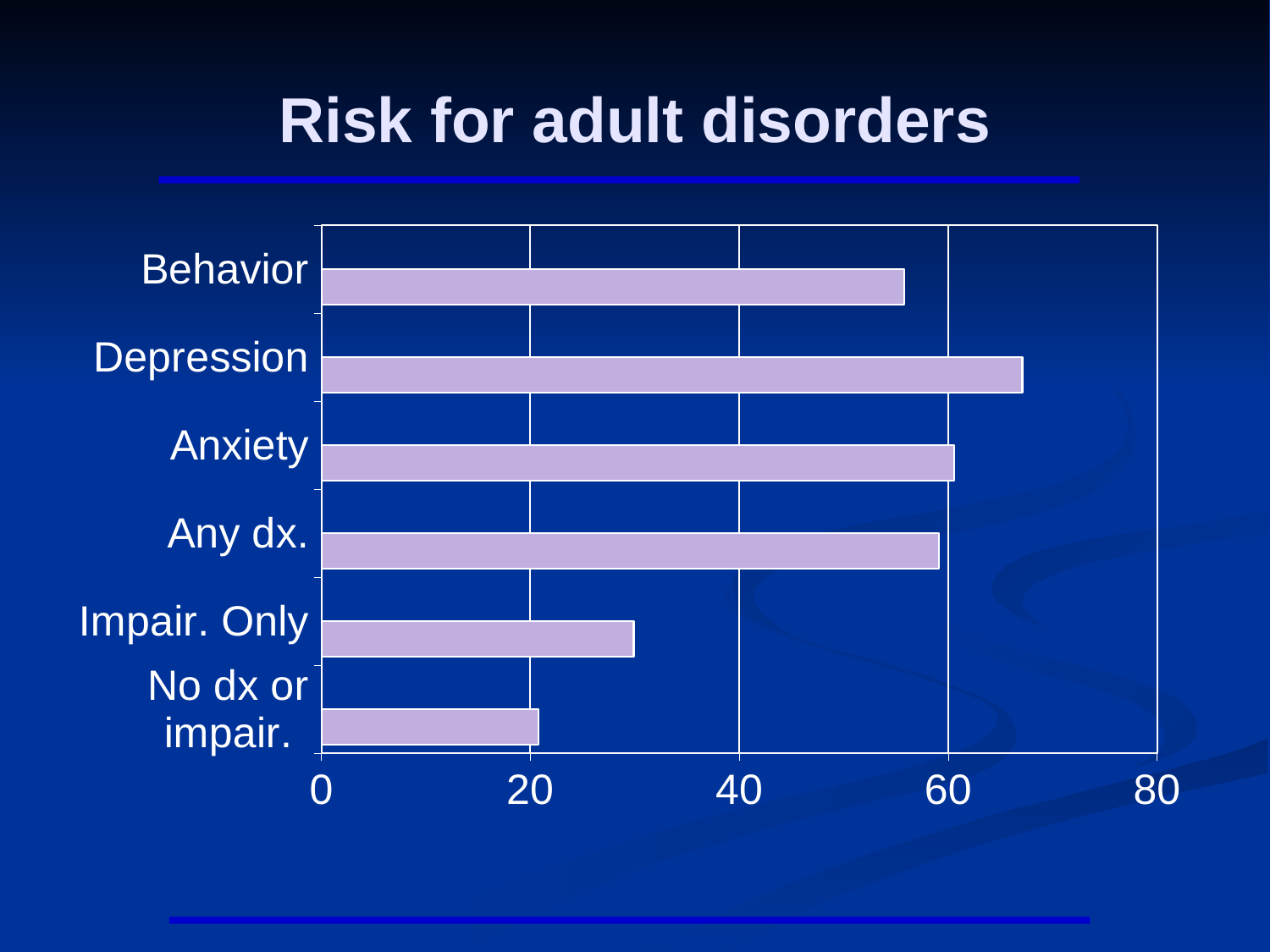
How many categories are plotted in the chart? 6 Is the value for Impair. Only greater or less than 40? less What kind of chart is shown on the slide? bar chart Which category has the highest value? Depression Which is larger, the value for Depression or the value for Behavior? Depression Which category has the lowest value? No dx or impair. Is the value for Behavior greater or less than 40? greater Is the value for Behavior greater or less than 60? less What is the title of the chart? Risk for adult disorders Which is larger, the value for Impair. Only or the value for No dx or impair.? Impair. Only